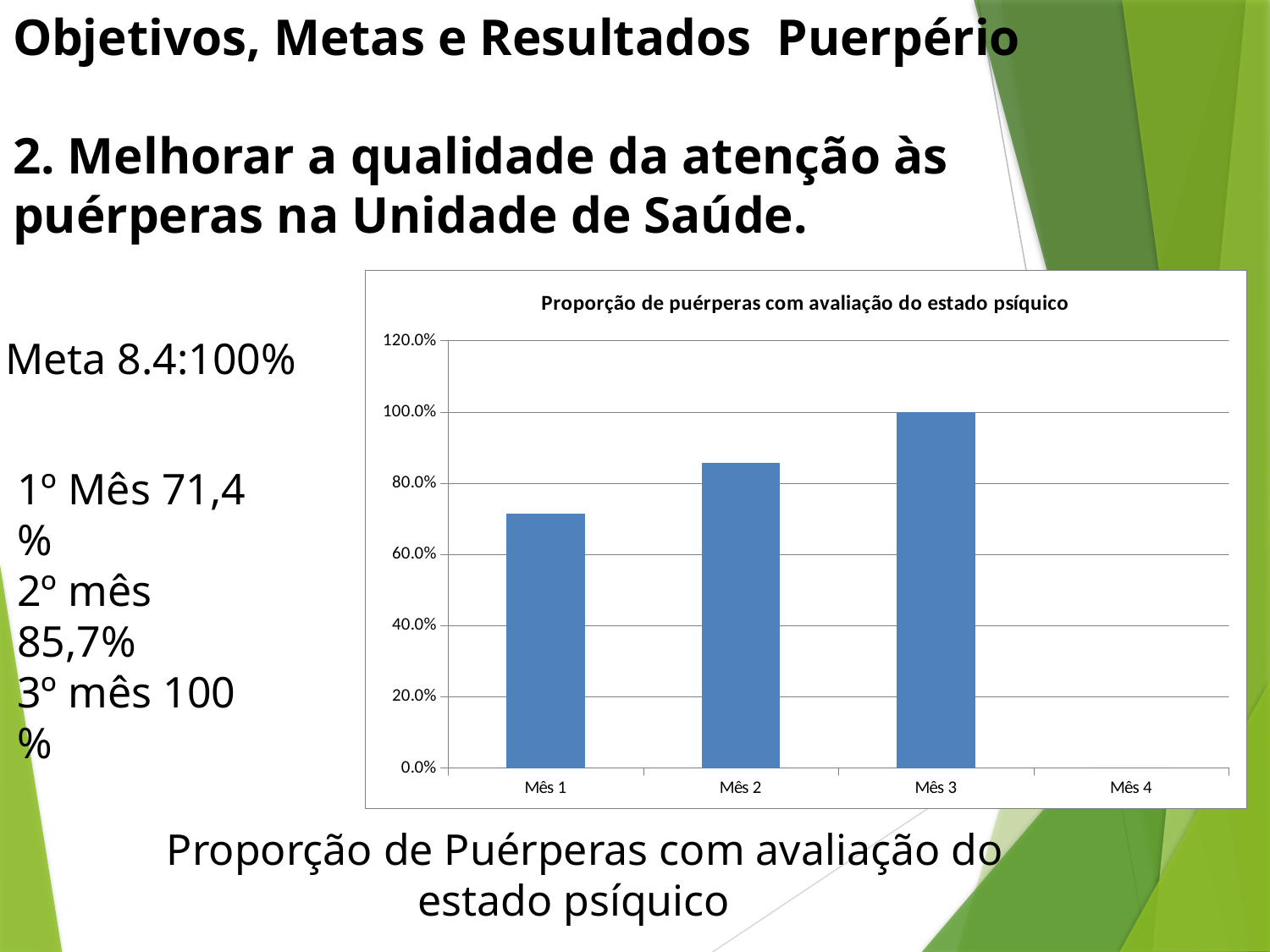
Which is larger, the value for Mês 1 or the value for Mês 2? Mês 2 How many categories are shown on the x axis? 4 Which of the plotted bars is the lowest? Mês 1 Which month has the highest bar? Mês 3 Is the value for Mês 1 greater or less than 80.0%? less What is the title of the chart? Proporção de puérperas com avaliação do estado psíquico Is the value for Mês 1 greater or less than 60.0%? greater Is the value for Mês 2 greater or less than 80.0%? greater What kind of chart is shown on the slide? bar chart What is the value for Mês 3? 100.0% Do the values rise or fall from Mês 1 to Mês 3? rise